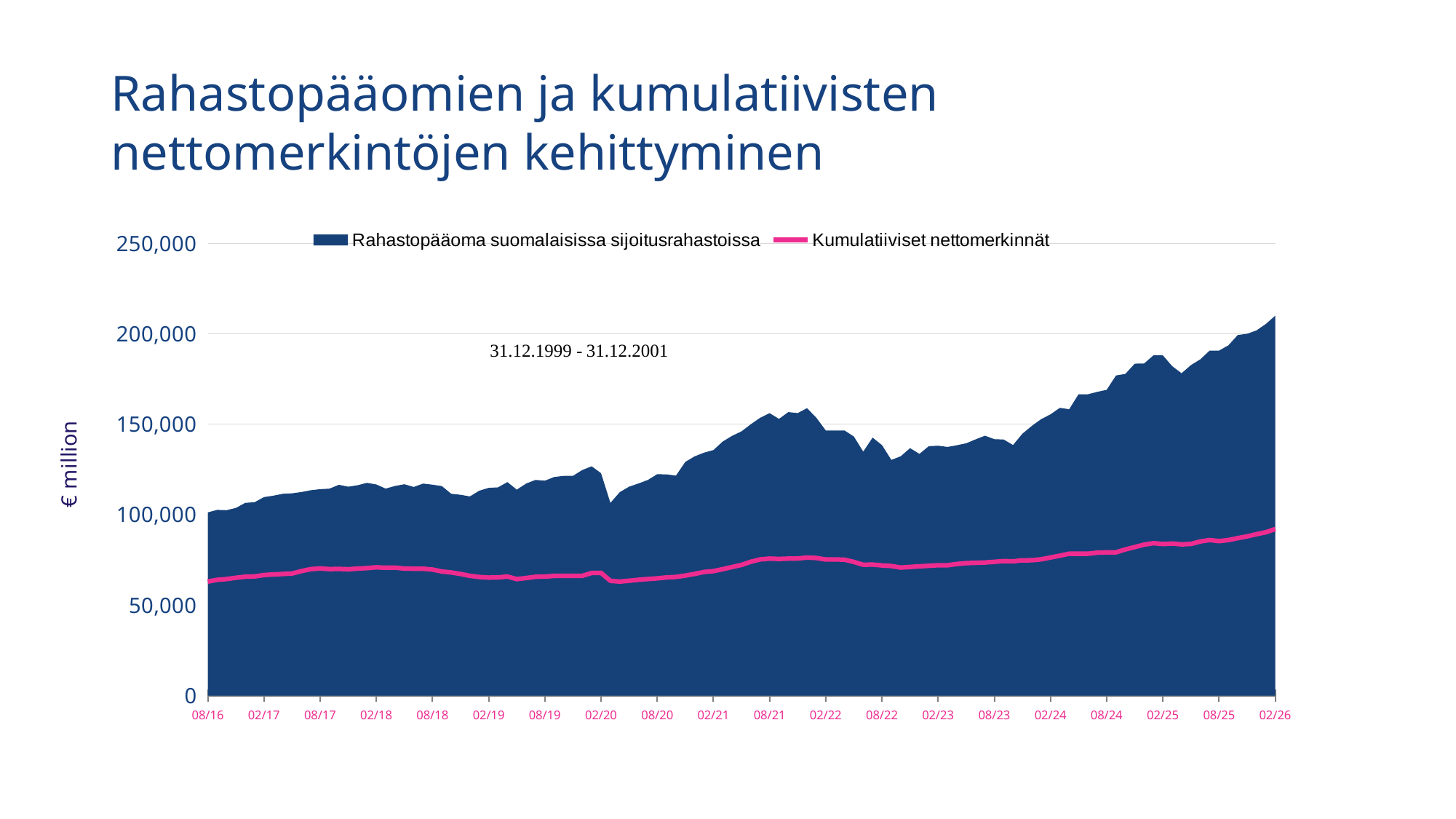
Is the value of Rahastopääoma suomalaisissa sijoitusrahastoissa at 02/20 greater or less than 150,000? less What unit is shown on the vertical axis of the chart? € million Is the value of Kumulatiiviset nettomerkinnät at 08/16 greater or less than 50,000? greater Is the value of Rahastopääoma suomalaisissa sijoitusrahastoissa at 02/26 greater or less than 200,000? greater How many series does the chart legend list? 2 At which x-axis label does Rahastopääoma suomalaisissa sijoitusrahastoissa reach its highest value? 02/26 Does the value of Rahastopääoma suomalaisissa sijoitusrahastoissa generally rise or fall from 08/16 to 02/26? rise At 02/26, which series has the higher value: Rahastopääoma suomalaisissa sijoitusrahastoissa or Kumulatiiviset nettomerkinnät? Rahastopääoma suomalaisissa sijoitusrahastoissa Does the value of Kumulatiiviset nettomerkinnät generally rise or fall from 08/16 to 02/26? rise What kind of chart is shown on the slide? combination area and line chart What is the title of the chart on the slide? Rahastopääomien ja kumulatiivisten nettomerkintöjen kehittyminen